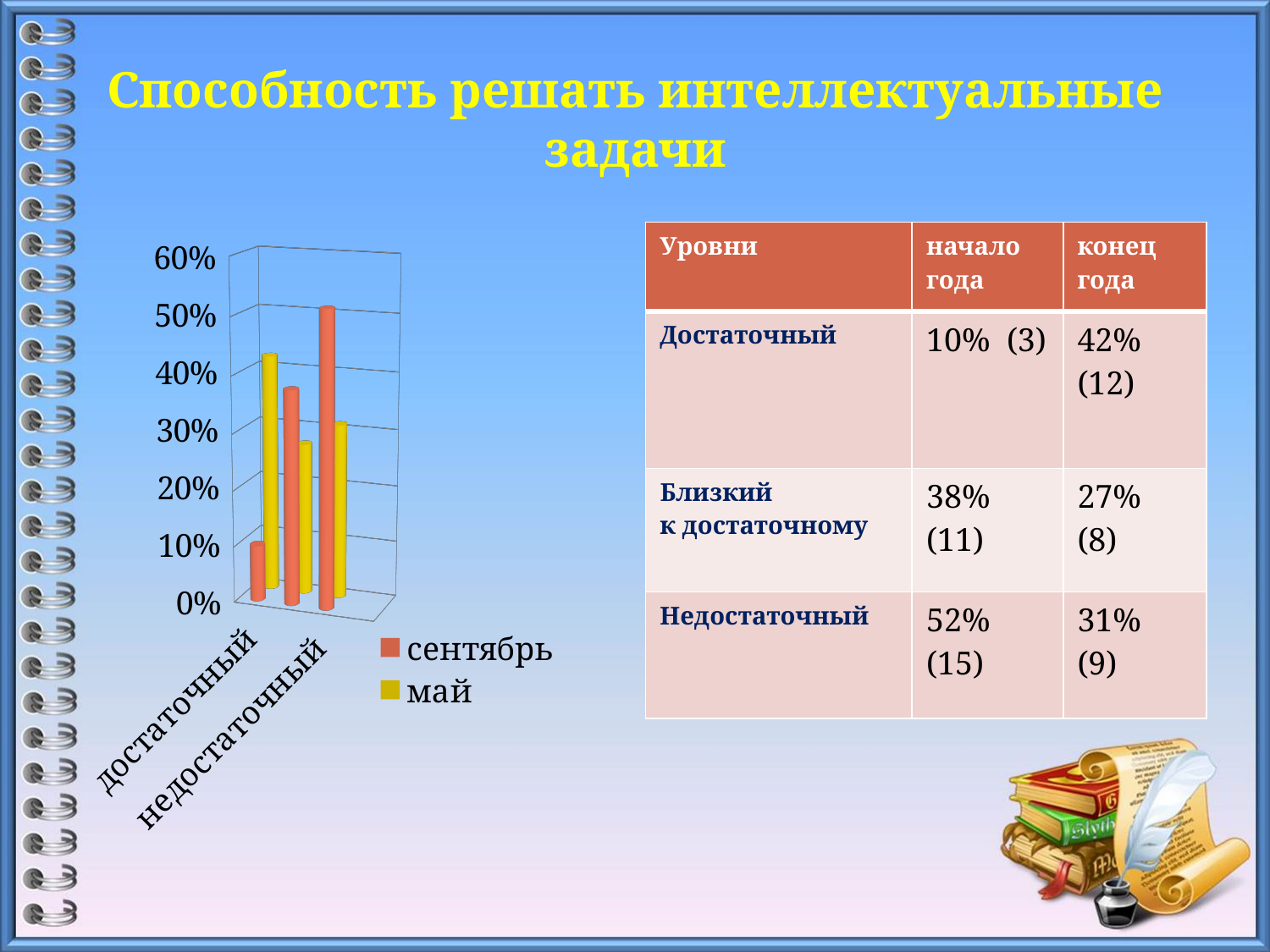
How many series does the chart legend list? 2 What are the two series named in the chart legend? сентябрь and май For недостаточный, which series has the larger value, сентябрь or май? сентябрь Which colour represents the май series in the chart? yellow For достаточный, which series has the larger value, сентябрь or май? май Is the сентябрь value for достаточный greater or less than 20%? less Is the май value for недостаточный greater or less than 40%? less Is the май value for достаточный greater or less than 30%? greater How many groups of bars (categories) are plotted in the chart? 3 What kind of chart is shown on the slide? bar chart Which bar in the chart is the tallest? сентябрь for недостаточный